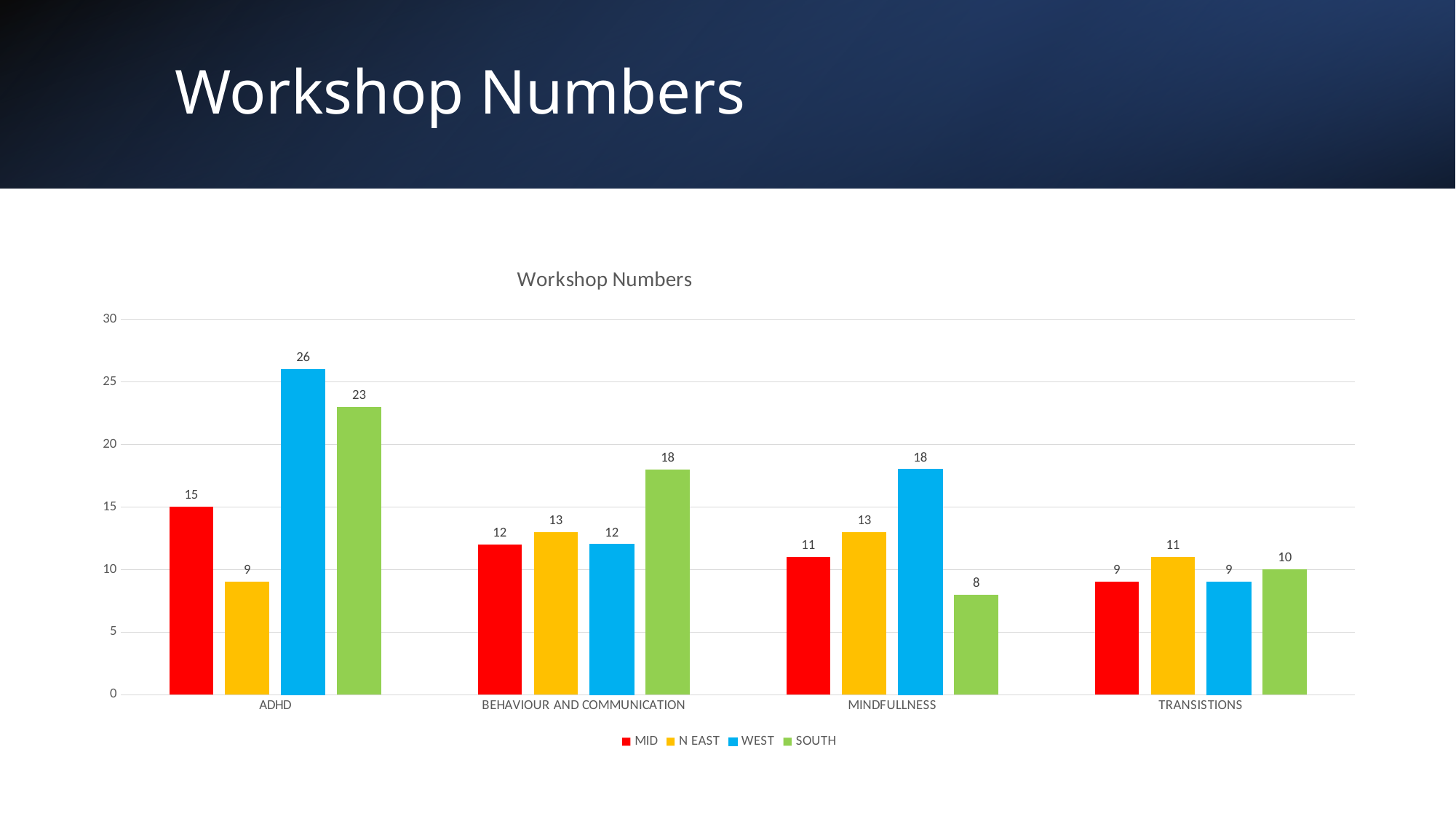
Which is larger: the MID value for ADHD or the MID value for MINDFULLNESS? ADHD Which series has the highest value in the BEHAVIOUR AND COMMUNICATION category? SOUTH What kind of chart is shown on the slide? Bar chart What is the difference between the WEST and SOUTH values in the ADHD category? 3 What colour represents the WEST series? Blue What is the value for N EAST in the TRANSISTIONS category? 11 What is the value for WEST in the ADHD category? 26 Which series has the lowest value in the ADHD category? N EAST How many categories are shown on the x axis? 4 How many series does the legend list? 4 Is the value for WEST in the MINDFULLNESS category greater or less than 15? greater What is the value for SOUTH in the MINDFULLNESS category? 8